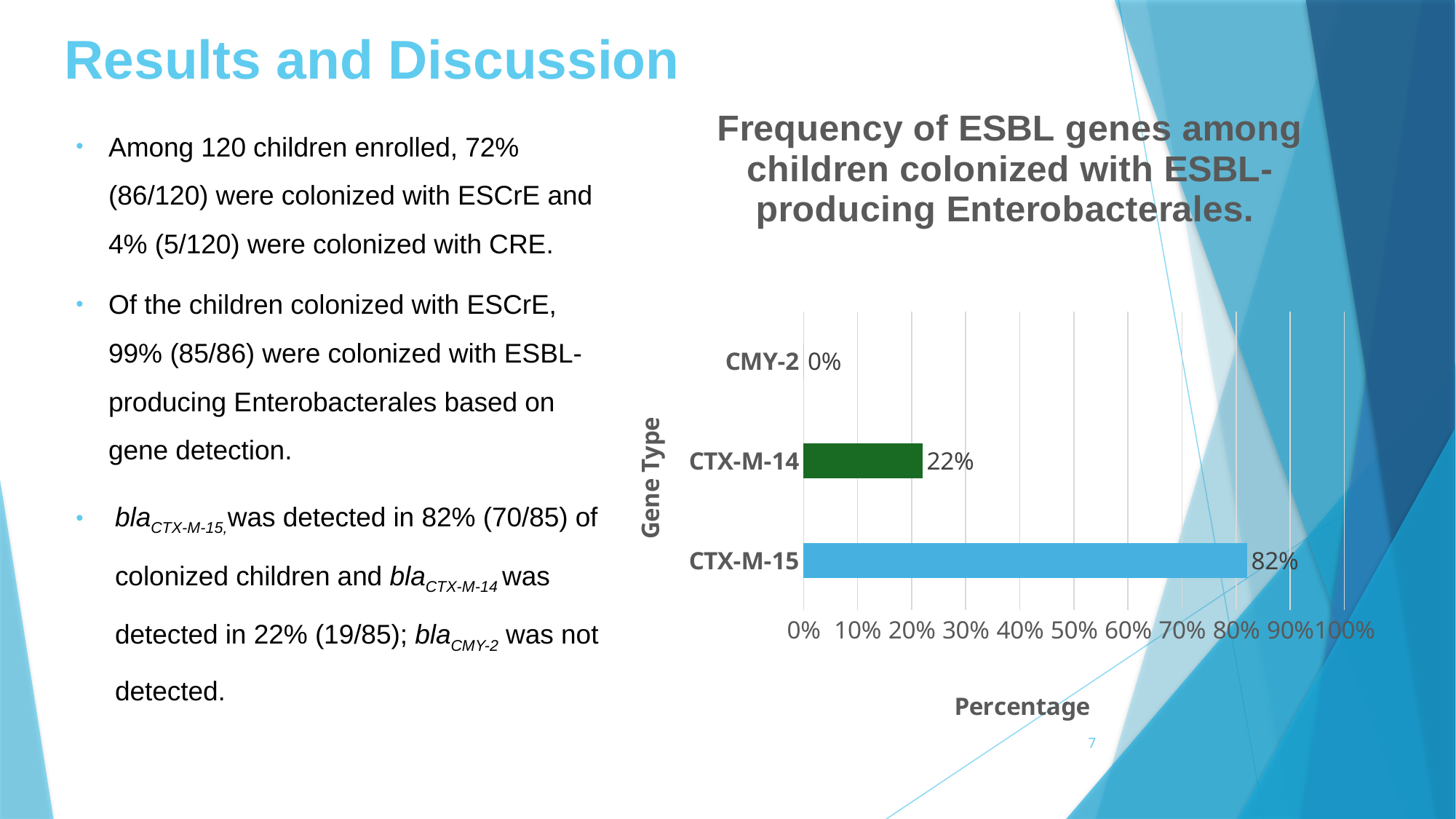
What is the label of the horizontal axis of the chart? Percentage What kind of chart is shown on the slide? bar chart How many gene types are shown in the chart? 3 Is the value for CTX-M-15 greater or less than 50%? greater What is the title of the chart? Frequency of ESBL genes among children colonized with ESBL-producing Enterobacterales. Which gene type has the lowest value? CMY-2 What is the difference between the values for CTX-M-15 and CTX-M-14? 60% What is the value for CTX-M-14? 22% Which gene type has the highest value? CTX-M-15 What is the value for CTX-M-15? 82% Which is larger, the value for CTX-M-14 or the value for CTX-M-15? CTX-M-15 What is the value for CMY-2? 0%